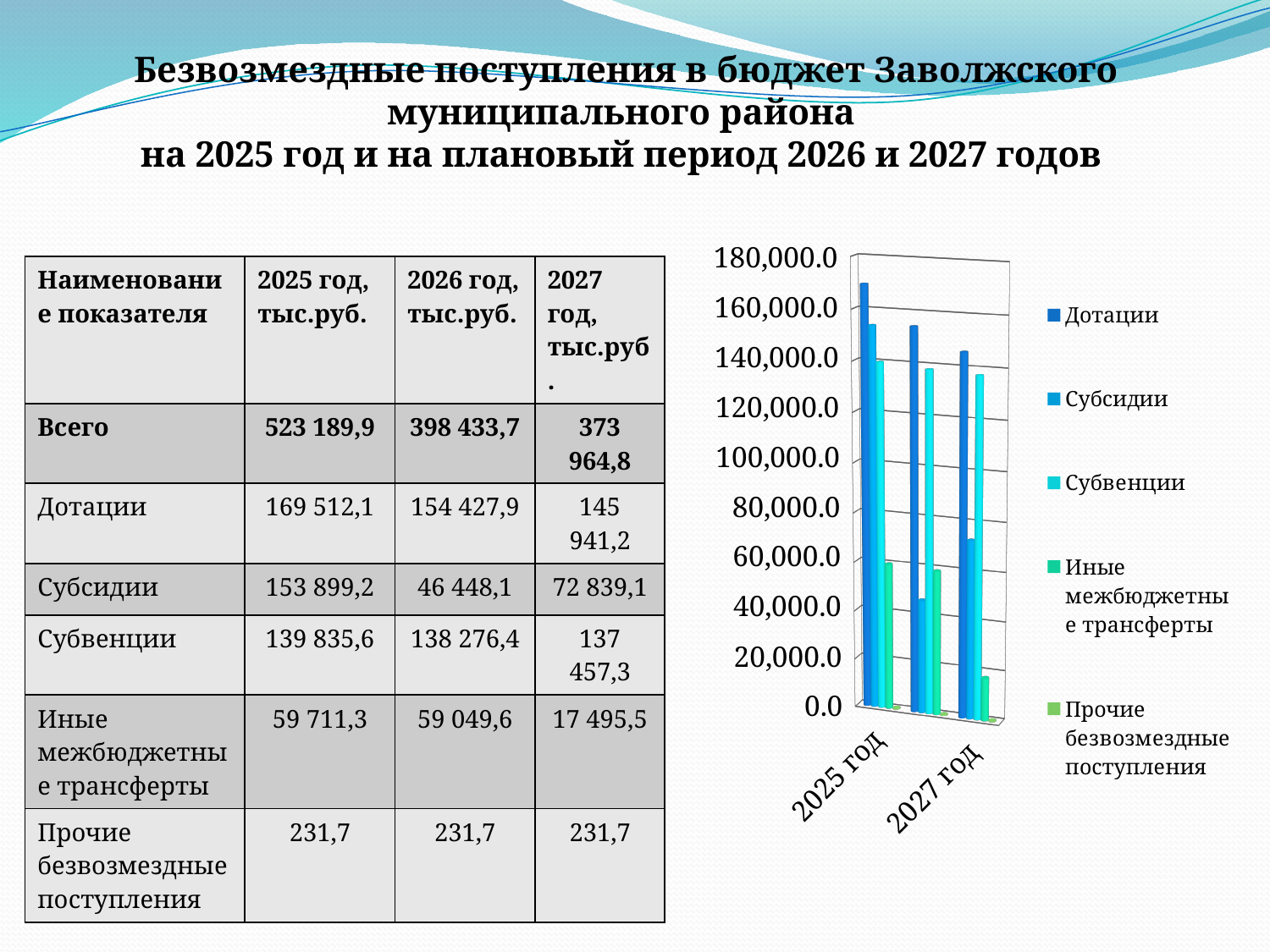
What is the difference between Субсидии in 2025 год and Субсидии in 2026 год? 107 451,1 Which series has the lowest value in 2027 год? Прочие безвозмездные поступления What is the highest value shown on the chart's vertical axis? 180,000.0 What is the value of Дотации for 2025 год? 169 512,1 Is the value for Субсидии in 2026 год greater or less than 60,000.0? less What is the value of Иные межбюджетные трансферты for 2027 год? 17 495,5 Which series has the highest value in 2025 год? Дотации How many series does the chart legend list? 5 Do the values for Дотации rise or fall from 2025 год to 2027 год? fall What kind of chart is shown on the slide? bar chart Is the value for Субвенции in 2025 год greater or less than 120,000.0? greater Which is larger: Дотации in 2025 год or Дотации in 2027 год? 2025 год